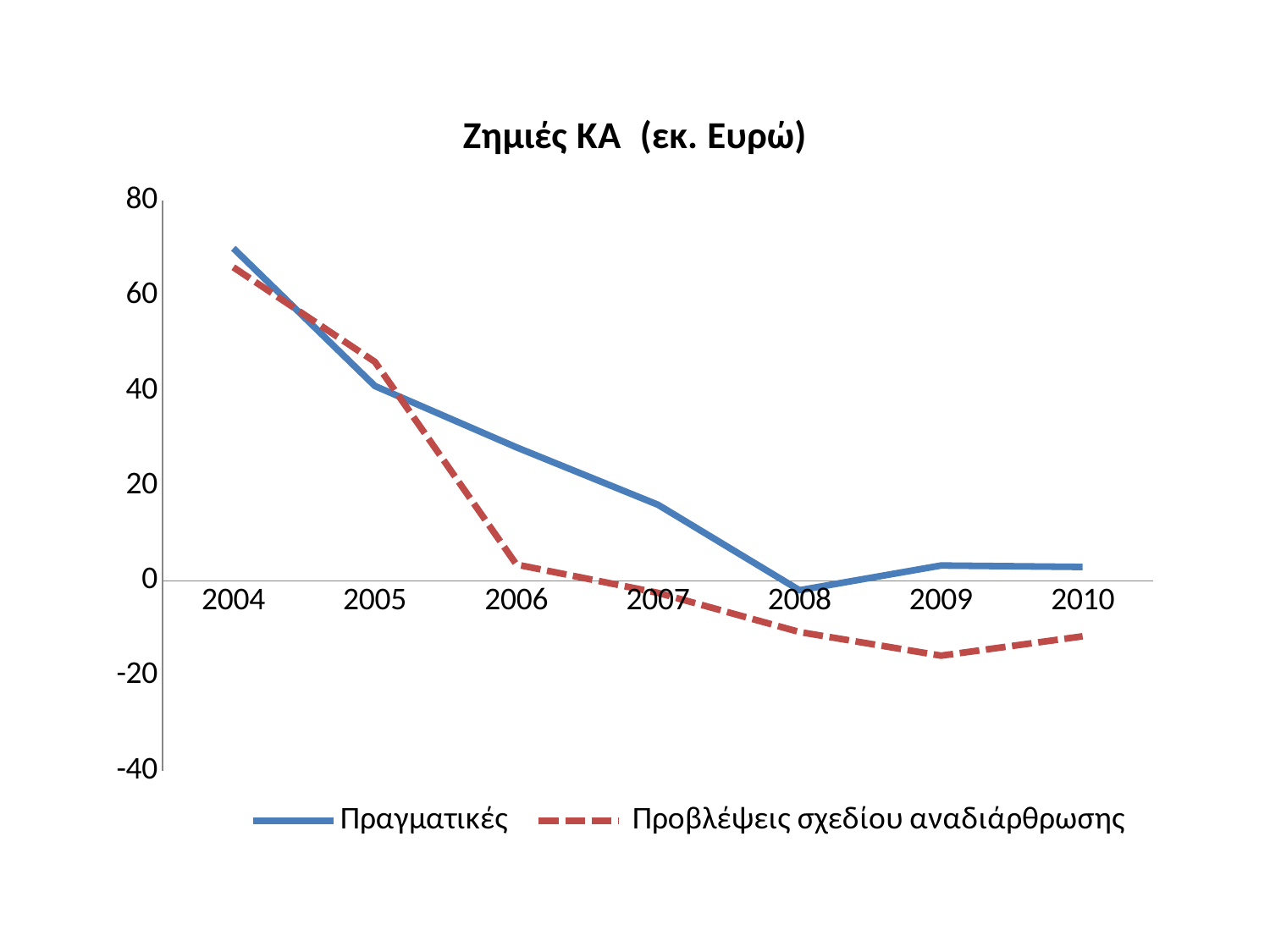
Which series is drawn with a dashed line? Προβλέψεις σχεδίου αναδιάρθρωσης What kind of chart is shown on the slide? line chart Does the Πραγματικές series generally rise or fall from 2004 to 2008? fall In which year is the Πραγματικές series at its highest? 2004 In which year is the Προβλέψεις σχεδίου αναδιάρθρωσης series at its lowest? 2009 How many series does the legend list? 2 In which year is the Πραγματικές series at its lowest? 2008 What is the title of the chart? Ζημιές ΚΑ (εκ. Ευρώ) Is the value for Πραγματικές in 2004 greater or less than 60? greater Is the value for Προβλέψεις σχεδίου αναδιάρθρωσης in 2009 greater or less than 0? less How many years are shown on the x axis? 7 In 2007, which series has the larger value, Πραγματικές or Προβλέψεις σχεδίου αναδιάρθρωσης? Πραγματικές